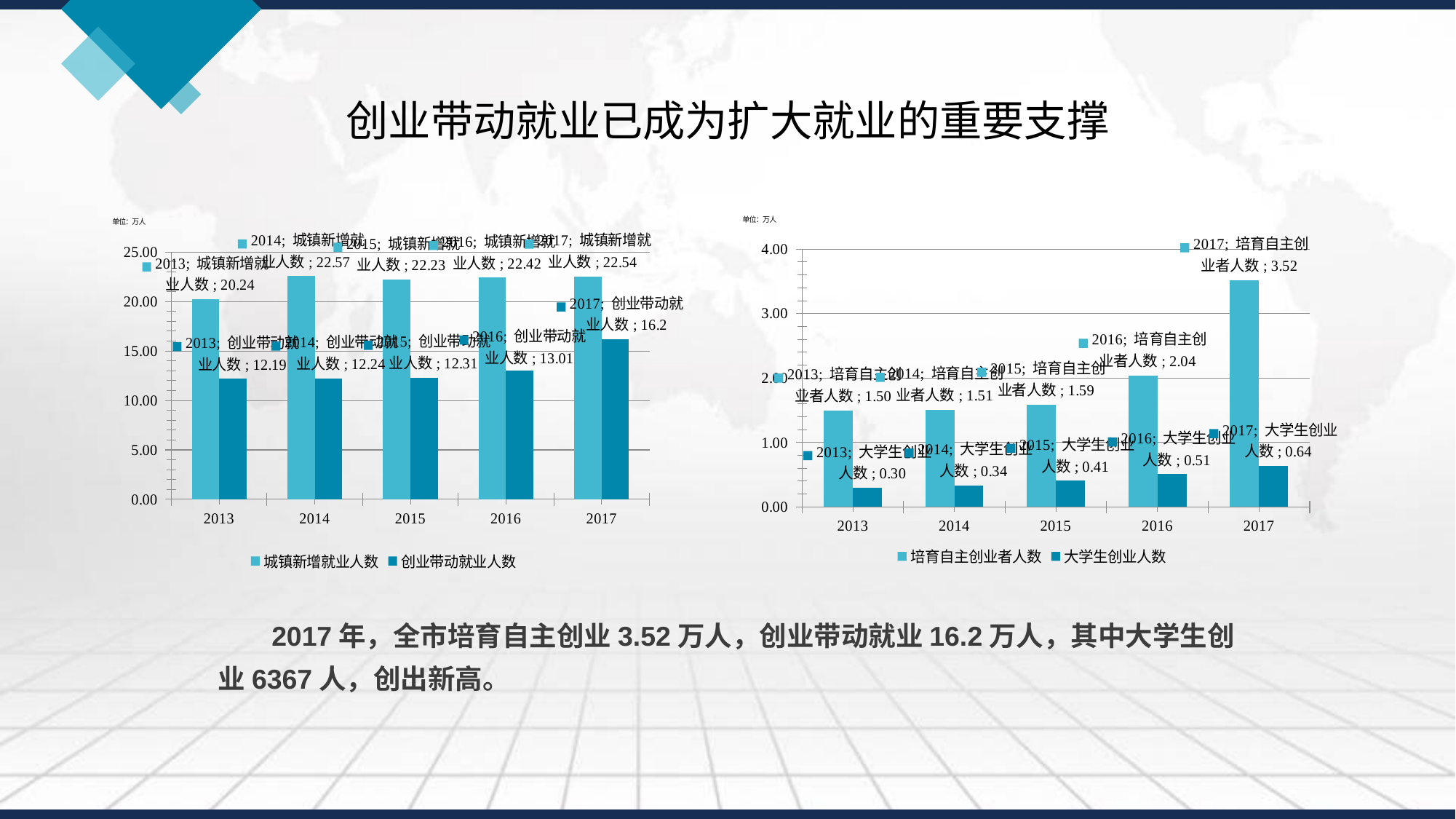
In the right chart, which is larger: 培育自主创业者人数 in 2014 or in 2015? 2015 In the left chart, what is the value of 创业带动就业人数 for 2017? 16.2 In the left chart, what is the value of 城镇新增就业人数 for 2013? 20.24 How many series does the legend of the right chart list? 2 In the left chart, which year has the highest 城镇新增就业人数? 2014 In the right chart, what is the difference in 培育自主创业者人数 between 2017 and 2016? 1.48 What type of chart is the left chart? bar chart In the right chart, what is the value of 大学生创业人数 for 2015? 0.41 In the right chart, what is the value of 培育自主创业者人数 for 2016? 2.04 In the right chart, which year has the lowest 大学生创业人数? 2013 In the left chart, what is the difference between 城镇新增就业人数 and 创业带动就业人数 in 2016? 9.41 In the left chart, does 创业带动就业人数 rise or fall from 2013 to 2017? rise